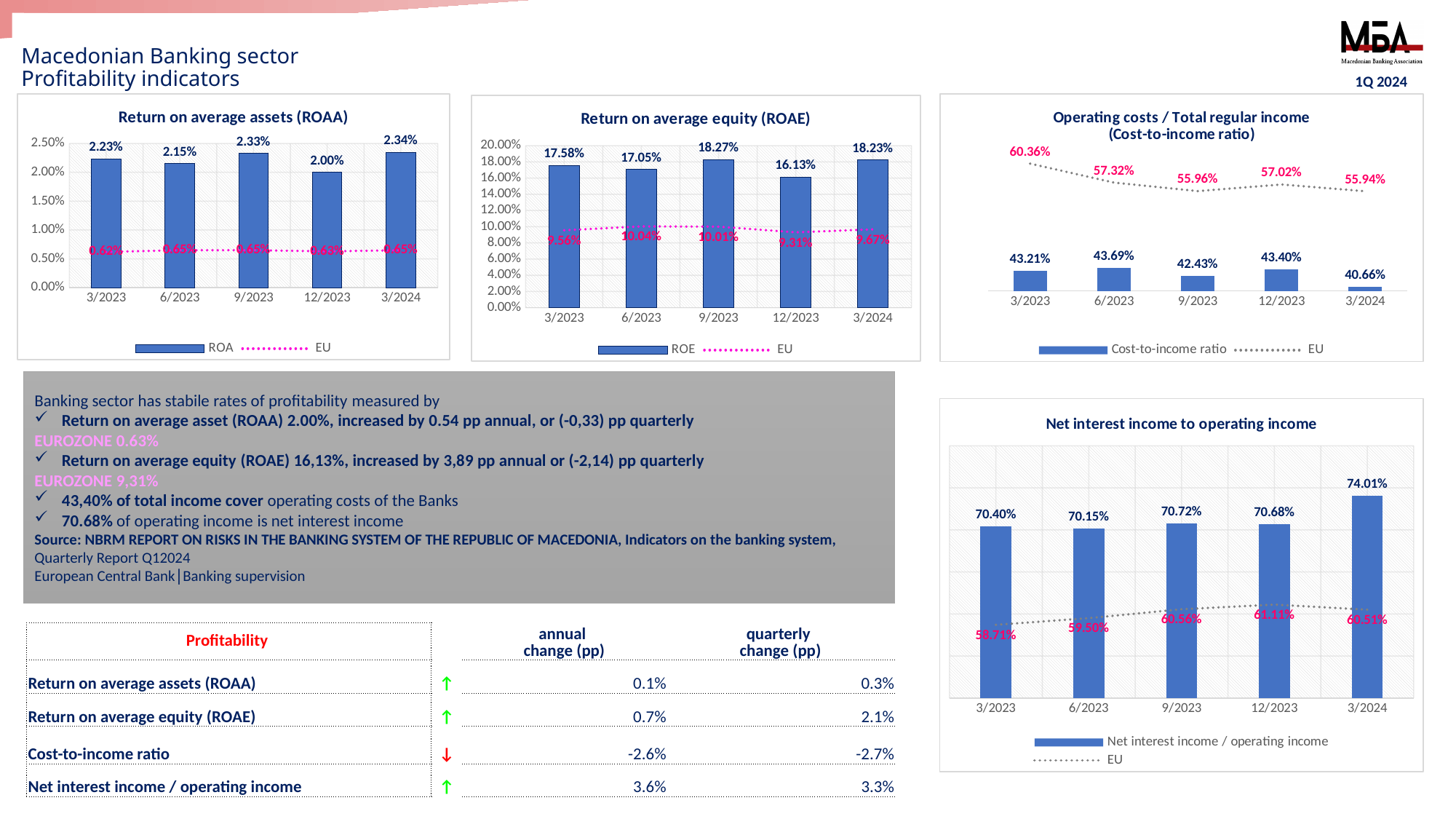
In the 'Operating costs / Total regular income (Cost-to-income ratio)' chart, which period has the highest EU value? 3/2023 In the 'Return on average equity (ROAE)' chart, what is the difference between the ROE and EU values for 3/2024? 8.56 pp In the 'Net interest income to operating income' chart, what is the EU value for 12/2023? 61.11% In the 'Net interest income to operating income' chart, which period has the highest Net interest income / operating income value? 3/2024 In the 'Return on average assets (ROAA)' chart, which period has the lowest ROA value? 12/2023 In the 'Operating costs / Total regular income (Cost-to-income ratio)' chart, is the Cost-to-income ratio or the EU value larger for 6/2023? EU In the 'Return on average equity (ROAE)' chart, which period has the lowest ROE value? 12/2023 In the 'Operating costs / Total regular income (Cost-to-income ratio)' chart, what is the Cost-to-income ratio for 3/2024? 40.66% In the 'Return on average equity (ROAE)' chart, what is the ROE value for 9/2023? 18.27% In the 'Return on average assets (ROAA)' chart, what is the EU value for 3/2023? 0.62% In the 'Return on average assets (ROAA)' chart, what is the ROA value for 12/2023? 2.00% How many periods are shown on the x axis of the 'Net interest income to operating income' chart? 5